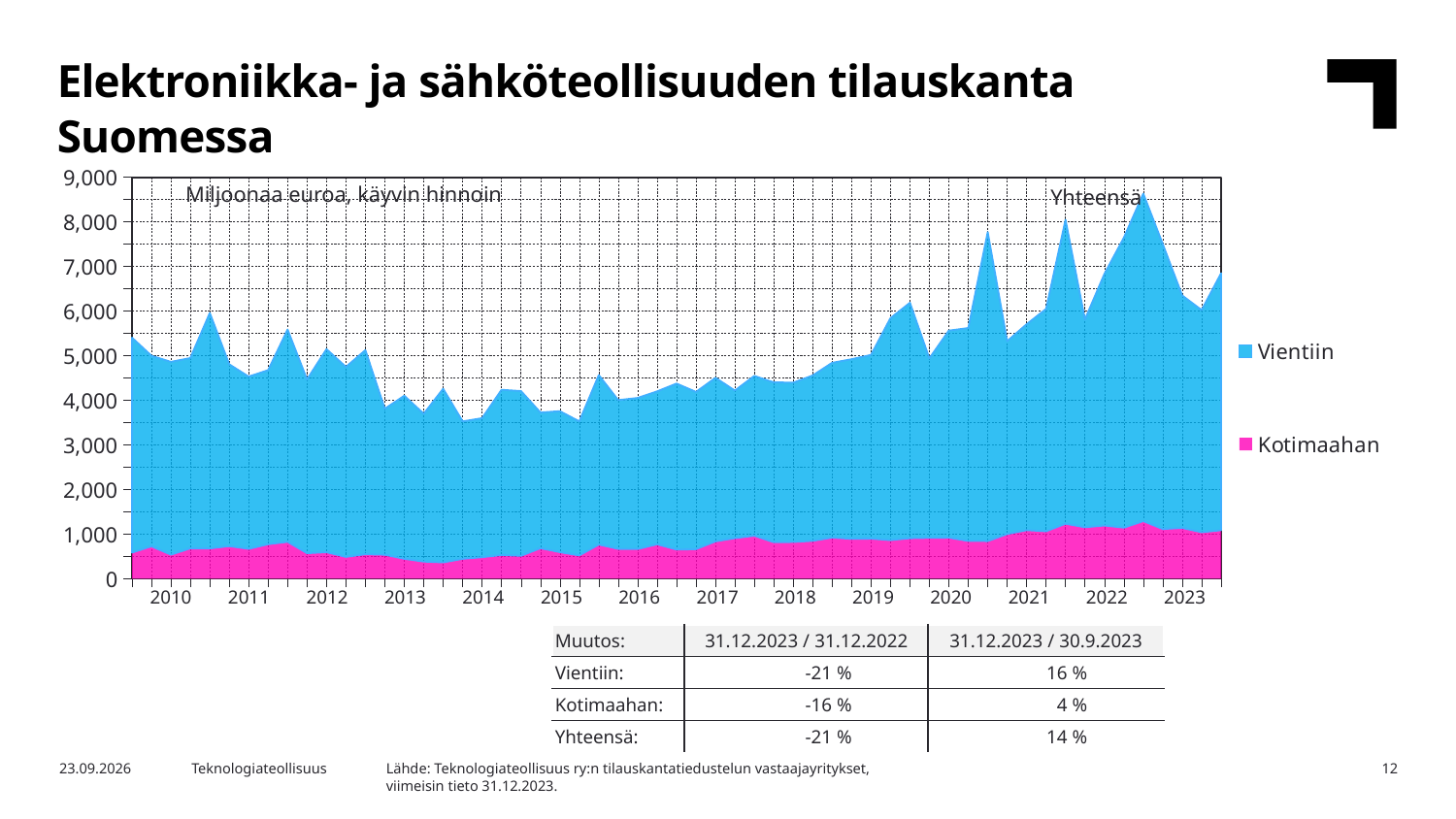
According to the table below the chart, what is the change in Yhteensä for 31.12.2023 / 31.12.2022? -21 % What kind of chart is shown on the slide? Stacked area chart What unit is stated in the label at the top left of the chart? Miljoonaa euroa, käyvin hinnoin Is the total value at the start of 2014 greater or less than 4,000? less Is the Kotimaahan value in 2014 greater or less than 1,000? less Which two series are listed in the chart legend? Vientiin and Kotimaahan Is the peak total value in 2022 greater or less than 8,000? greater Does the total order book generally rise or fall between 2015 and 2022? rise In which year does the total (Yhteensä) reach its highest peak? 2022 Which series is larger throughout the chart, Vientiin or Kotimaahan? Vientiin How many series does the chart legend list? 2 How many years are labelled on the x axis of the chart? 14